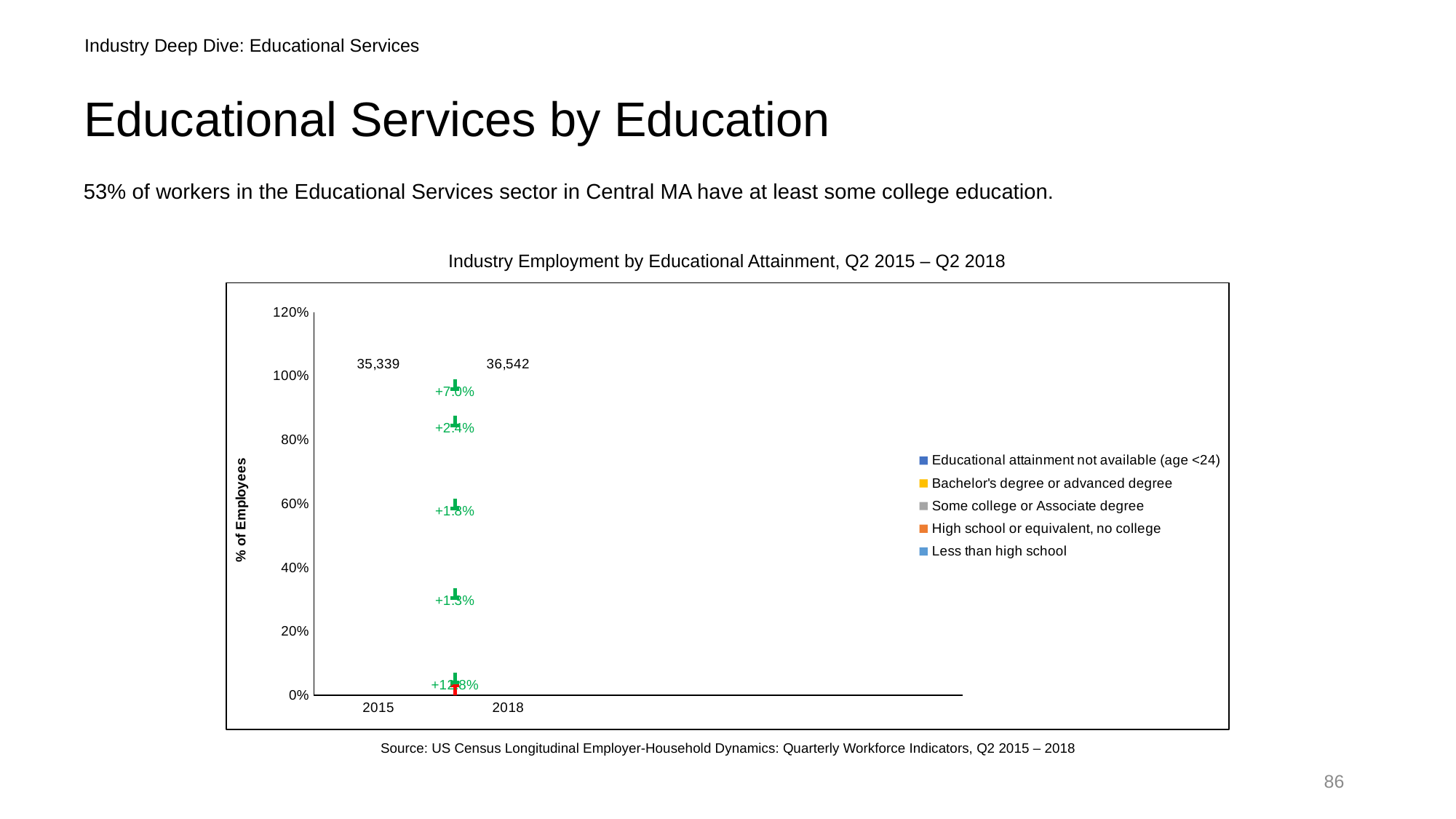
Does the total employment figure printed on the chart rise or fall from 2015 to 2018? rise Which year has the larger total employment figure printed above it, 2015 or 2018? 2018 What total employment figure is printed above the 2015 category? 35,339 What total employment figure is printed above the 2018 category? 36,542 How many categories are shown on the x axis of the chart? 2 What is the label on the y axis of the chart? % of Employees How many series does the chart's legend list? 5 Which two years are shown on the x axis of the chart? 2015 and 2018 What is the title of the chart? Industry Employment by Educational Attainment, Q2 2015 – Q2 2018 What is the difference between the total employment figures printed for 2018 and 2015? 1,203